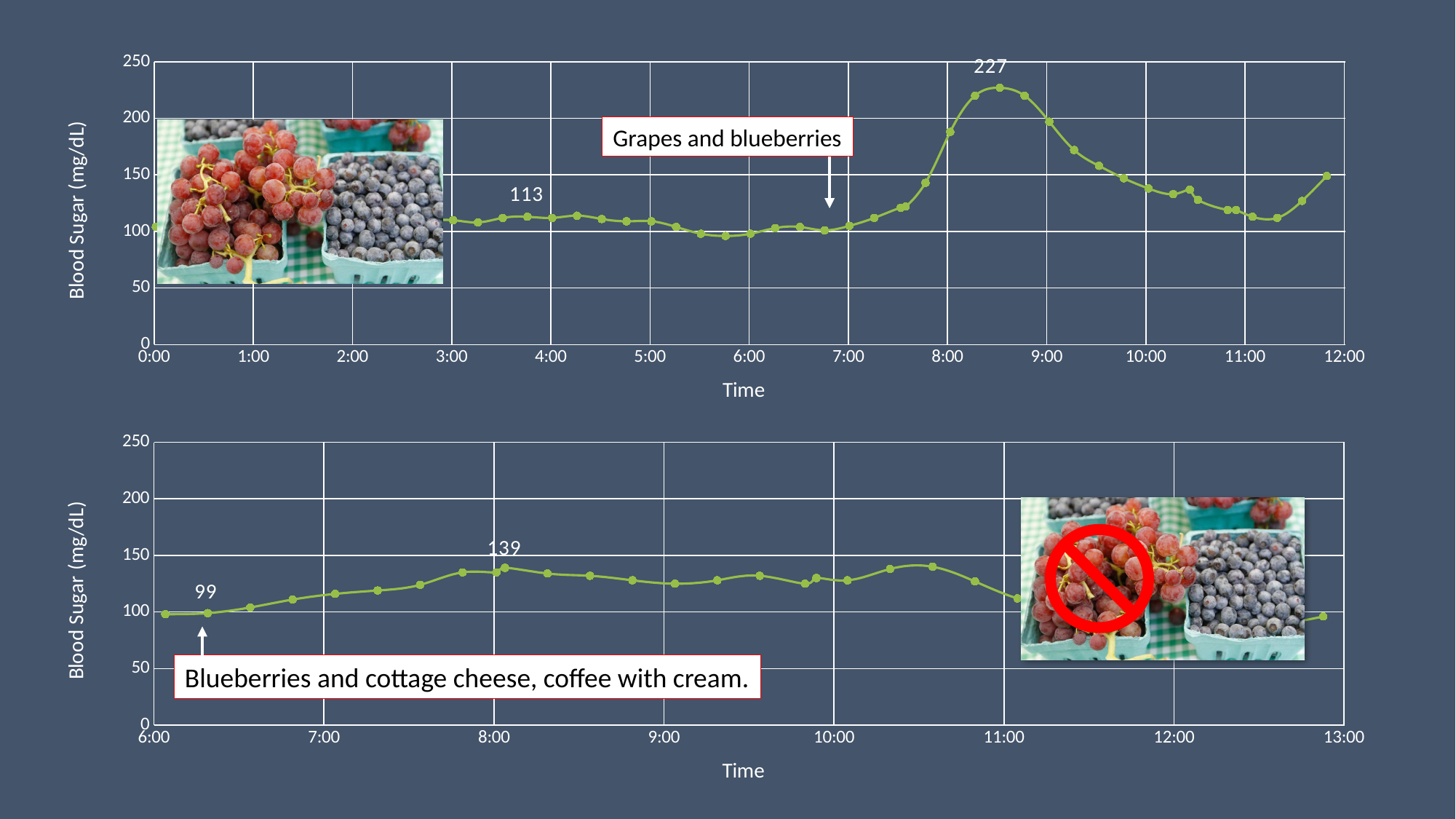
Which chart has the higher labelled peak blood sugar value, the top chart or the bottom chart? the top chart In the top chart, what is the highest blood sugar value labelled on the line? 227 In the bottom chart, what is the difference between the labelled values 139 and 99? 40 In the bottom chart, what value is labelled at the start of the line near 6:00? 99 In the bottom chart, is the blood sugar value at 10:00 greater or less than 100? greater What kind of chart is the top chart? line chart In the top chart, what is the difference between the labelled peak value and the labelled value of 113? 114 In the top chart, what value is labelled on the line shortly after 3:00? 113 In the bottom chart, what is the highest blood sugar value labelled on the line? 139 In the top chart, does the blood sugar rise or fall between 7:00 and 8:30? rise In the top chart, is the blood sugar value at 9:00 greater or less than 150? greater In the top chart, is the blood sugar value at 11:00 greater or less than 150? less